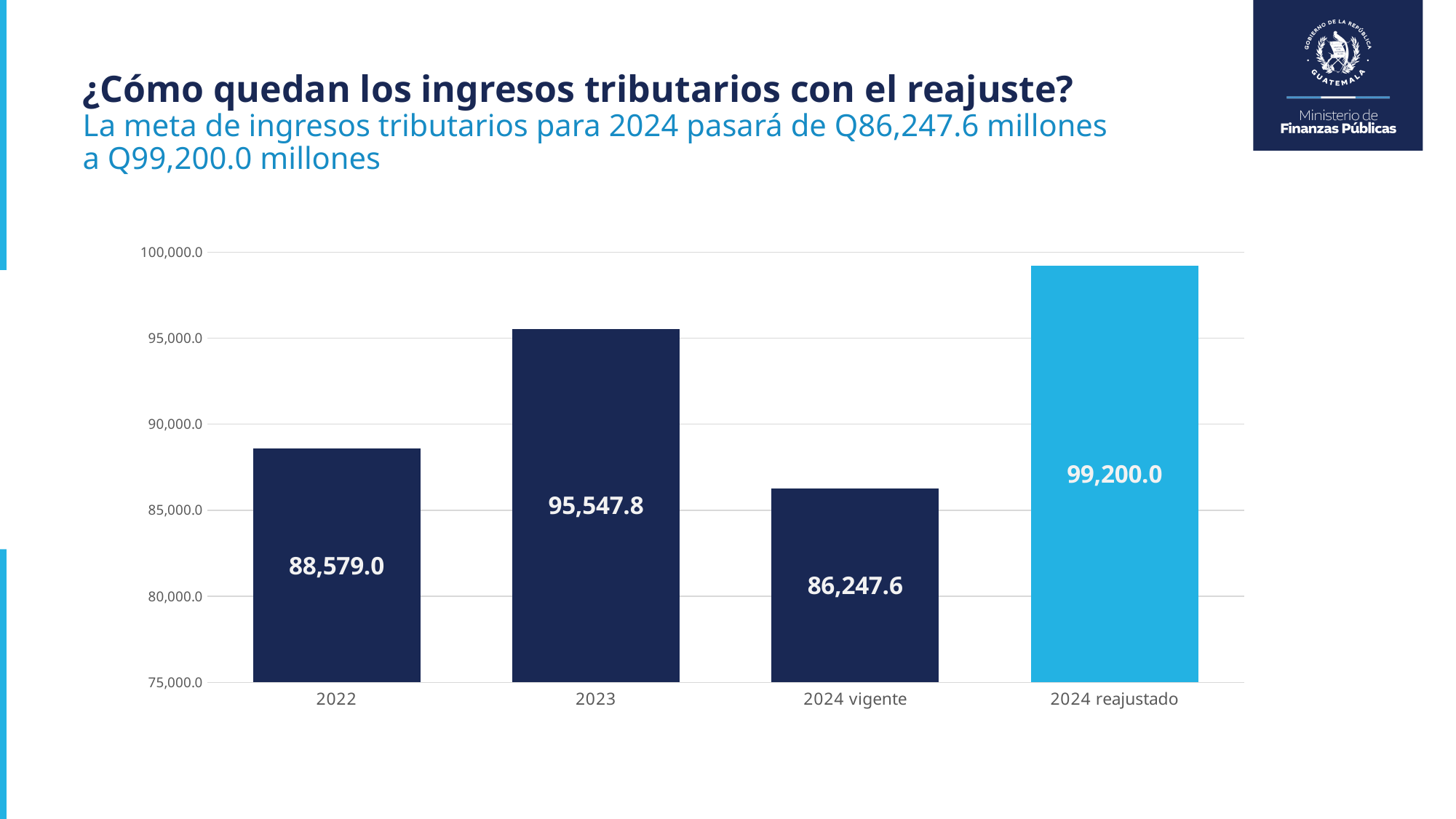
Which category has the highest value? 2024 reajustado What is the value for 2022? 88,579.0 What is the value for 2023? 95,547.8 Is the value for 2023 greater or less than 95,000.0? greater What is the value for 2024 vigente? 86,247.6 What is the value for 2024 reajustado? 99,200.0 What kind of chart is shown on the slide? Bar chart Which is larger, the value for 2022 or the value for 2024 vigente? 2022 What is the difference between the values for 2023 and 2022? 6,968.8 How many bars are shown in the chart? 4 What is the difference between the values for 2024 reajustado and 2024 vigente? 12,952.4 Which category has the lowest value? 2024 vigente